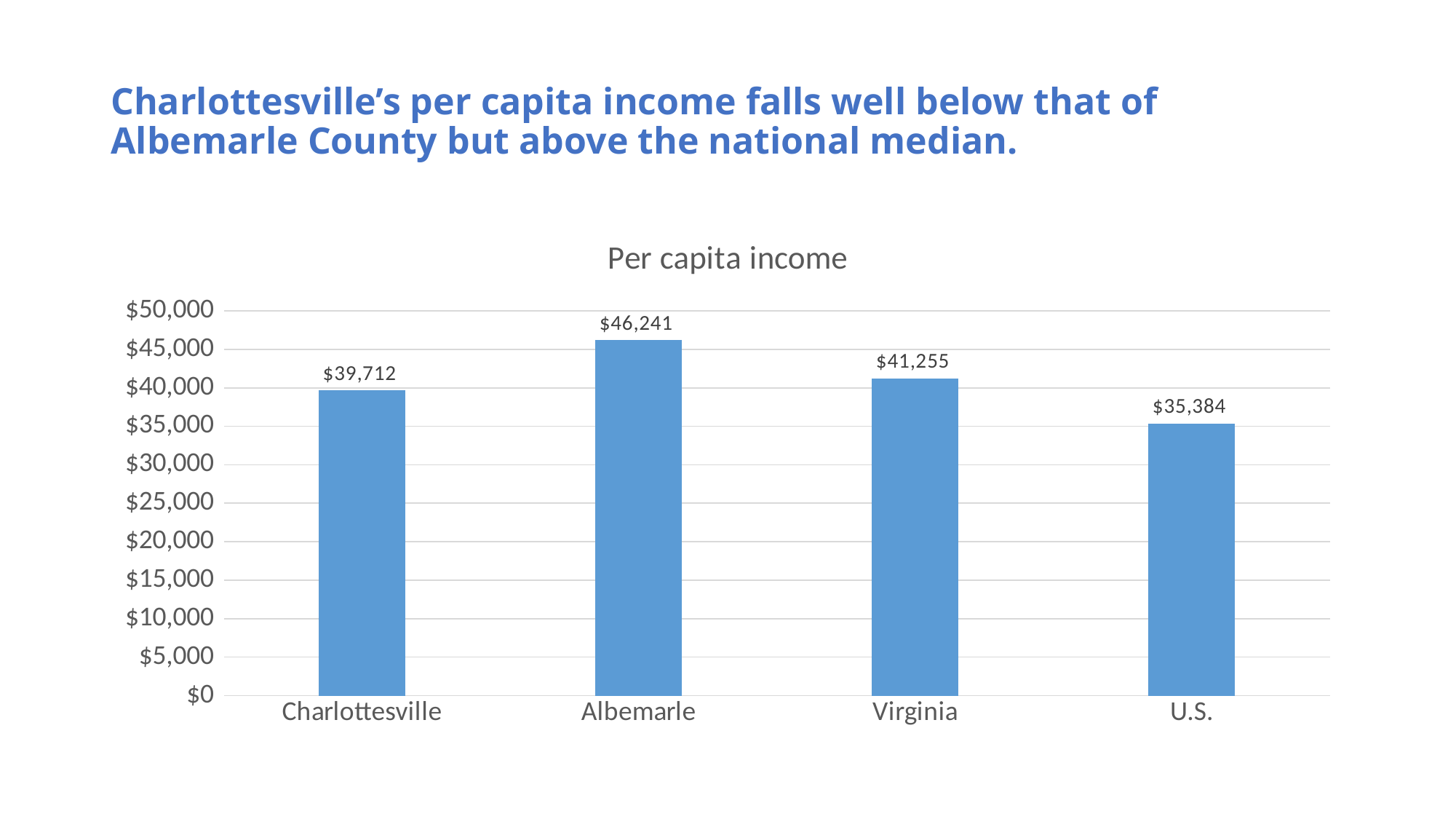
What is the per capita income for the U.S.? $35,384 Which category has the lowest per capita income? U.S. What is the per capita income for Albemarle? $46,241 Which has a higher per capita income, Virginia or Charlottesville? Virginia Which category has the highest per capita income? Albemarle What is the per capita income for Virginia? $41,255 What is the difference between the per capita income of Albemarle and Charlottesville? $6,529 What type of chart is shown on the slide? Bar chart What is the difference between the per capita income of Charlottesville and the U.S.? $4,328 Is the per capita income for the U.S. greater or less than $40,000? less What is the per capita income for Charlottesville? $39,712 How many categories are shown in the chart? 4